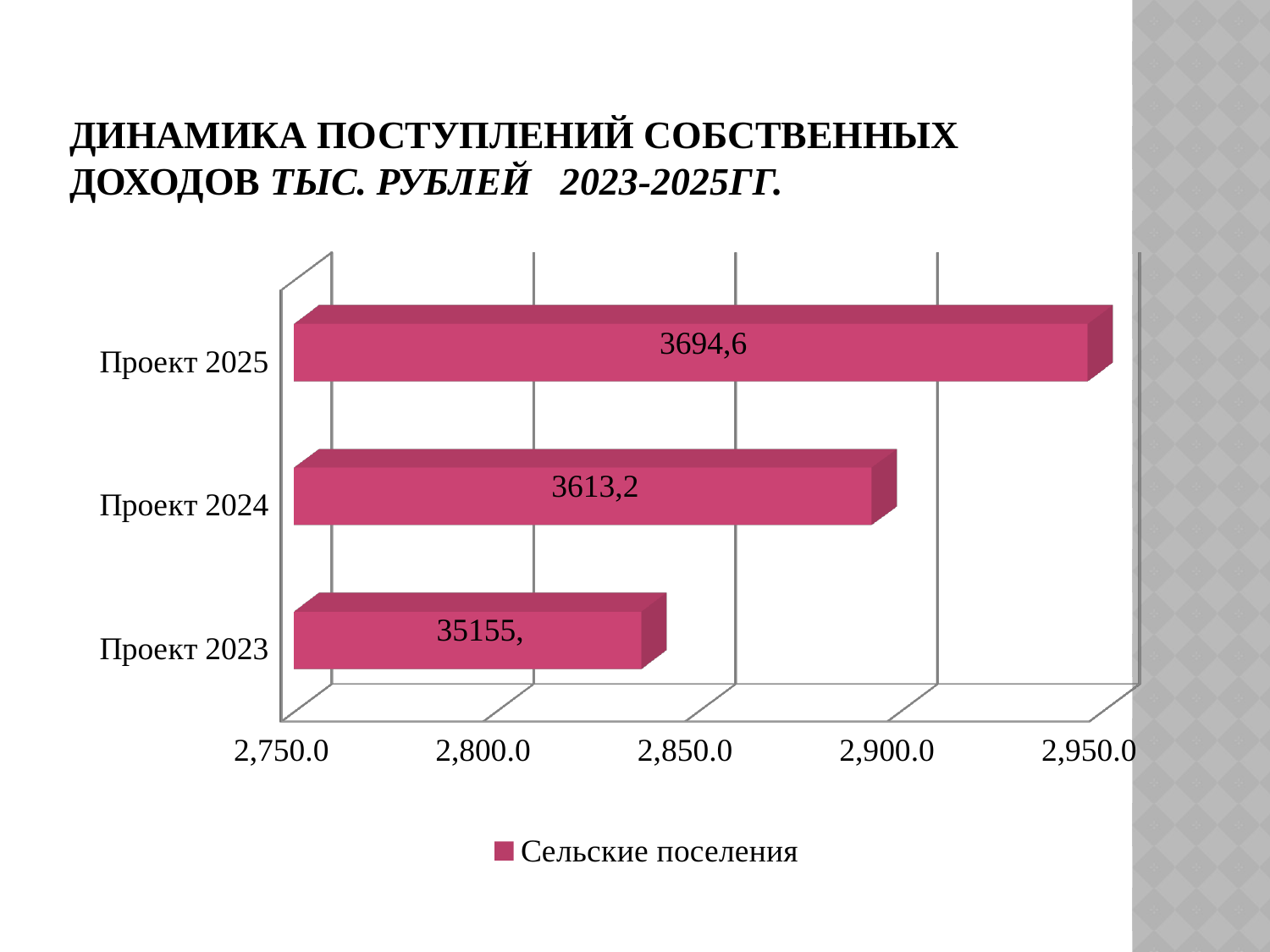
What is the difference between the labelled values for Проект 2025 and Проект 2024? 81,4 What value is labelled on the bar for Проект 2025? 3694,6 Is the bar for Проект 2025 greater or less than 2,900.0 on the axis? greater What label is printed on the bar for Проект 2023? 35155, How many series does the legend list? 1 What kind of chart is shown on the slide? Bar chart Which category has the shortest bar? Проект 2023 What value is labelled on the bar for Проект 2024? 3613,2 Which bar is longer, Проект 2024 or Проект 2023? Проект 2024 Which category has the longest bar? Проект 2025 How many categories are shown on the chart? 3 Is the bar for Проект 2023 greater or less than 2,850.0 on the axis? less